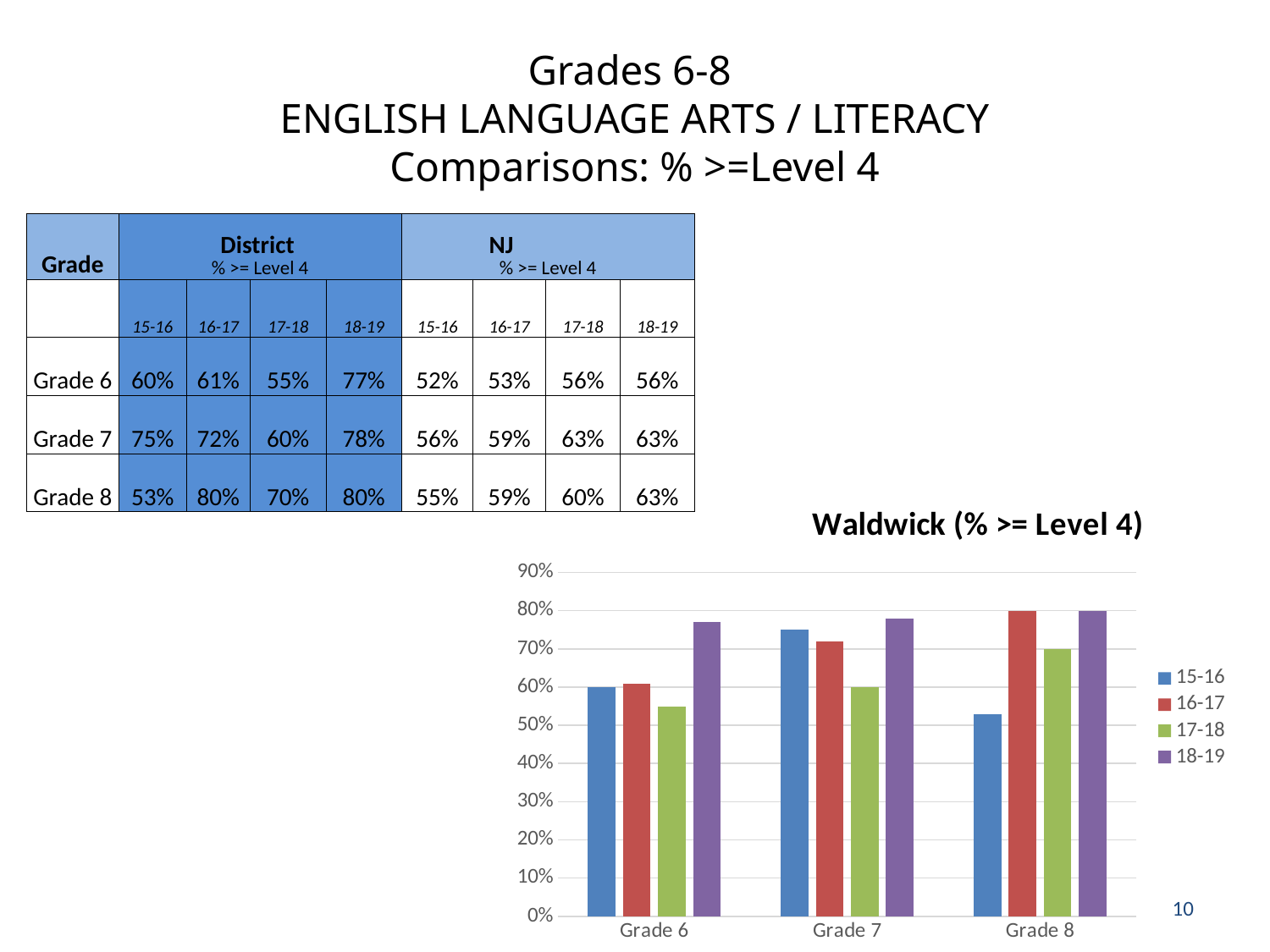
What is the title of the chart? Waldwick (% >= Level 4) What kind of chart is shown on the slide? Bar chart In the chart, what is the difference between the 16-17 and 17-18 values for Grade 8? 10 percentage points In the chart, what is the value for Grade 8 in the 16-17 series? 80% In the chart, which series has the highest bar for Grade 6? 18-19 In the chart, which series has the lowest bar for Grade 8? 15-16 In the chart, which is larger for Grade 7: the 15-16 bar or the 17-18 bar? 15-16 How many series does the chart's legend list? 4 In the chart, what is the value for Grade 6 in the 15-16 series? 60% How many grade categories are shown on the x axis of the chart? 3 In the chart, what is the value for Grade 8 in the 17-18 series? 70% Is the value for Grade 8 in the 15-16 series greater or less than 60%? less